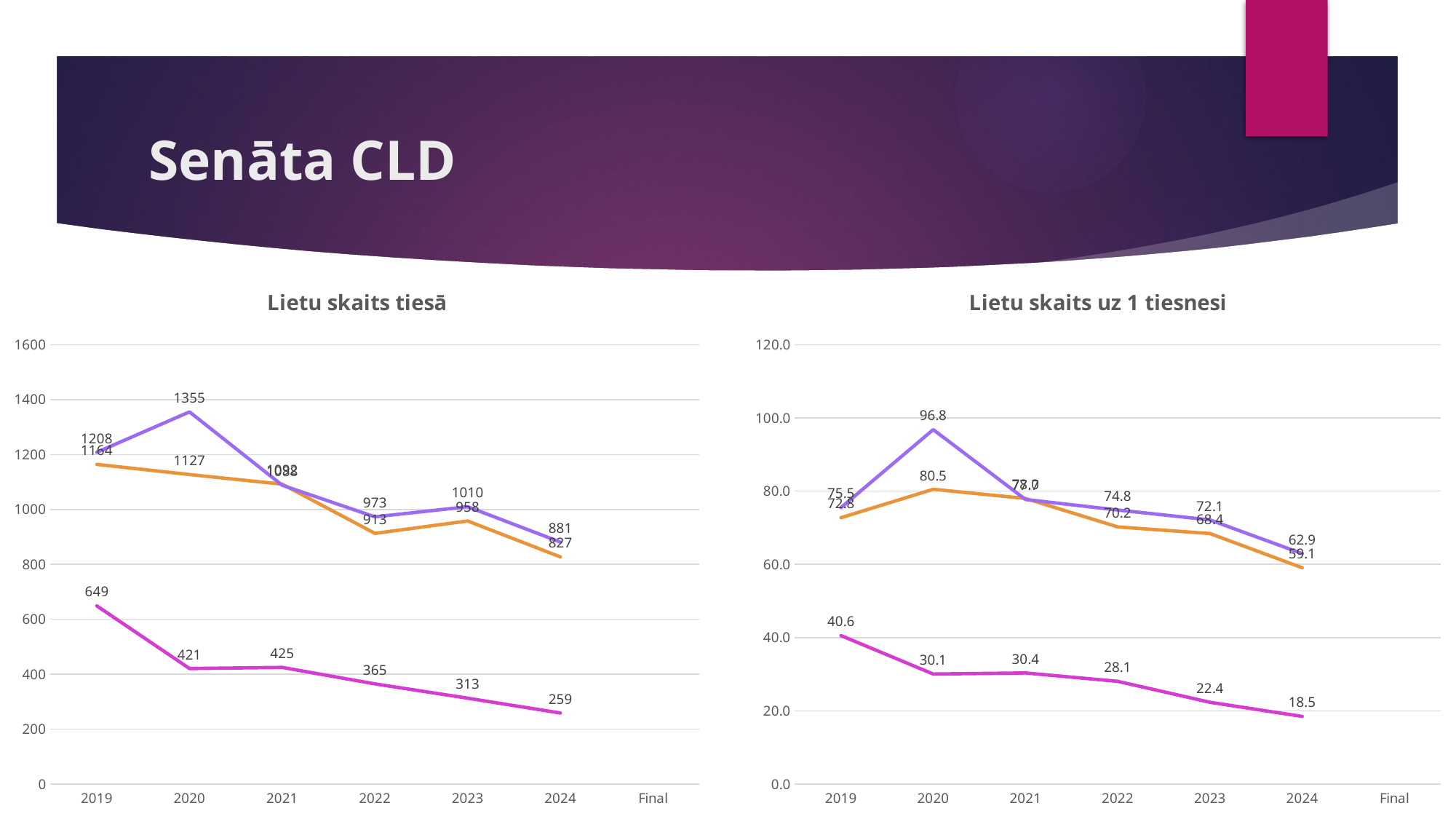
In the chart "Lietu skaits tiesā", what is the value of the pink line in 2019? 649 In the chart "Lietu skaits uz 1 tiesnesi", what is the value of the pink line in 2024? 18.5 In the chart "Lietu skaits uz 1 tiesnesi", which line has the higher value in 2023, the purple line or the orange line? purple line In the chart "Lietu skaits tiesā", does the pink line generally rise or fall from 2019 to 2024? fall In the chart "Lietu skaits uz 1 tiesnesi", what is the value of the purple line in 2020? 96.8 In the chart "Lietu skaits tiesā", in which year does the purple line reach its highest value? 2020 In the chart "Lietu skaits tiesā", by how much does the pink line's value in 2019 exceed its value in 2024? 390 In the chart "Lietu skaits tiesā", what is the value of the purple line in 2020? 1355 What kind of chart is the left chart titled "Lietu skaits tiesā"? line chart In the chart "Lietu skaits uz 1 tiesnesi", what is the difference between the orange line's value in 2020 and its value in 2024? 21.4 In the chart "Lietu skaits uz 1 tiesnesi", in which year is the pink line at its lowest value? 2024 In the chart "Lietu skaits tiesā", what is the value of the orange line in 2022? 913